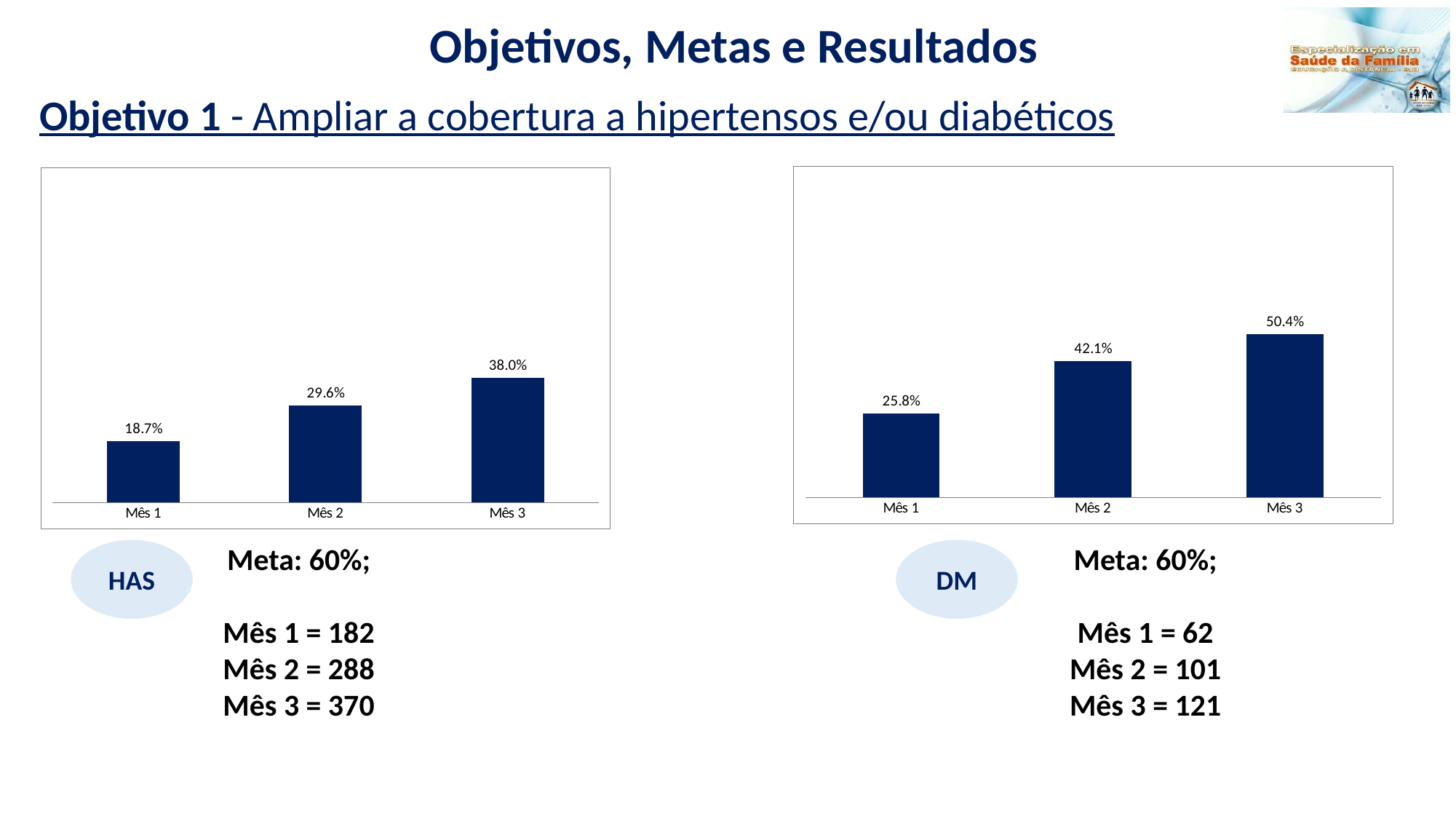
In the left chart (HAS), what is the value for Mês 3? 38.0% In the left chart (HAS), what is the difference between Mês 3 and Mês 1? 19.3% In the right chart (DM), what is the value for Mês 3? 50.4% What kind of chart is the right chart (DM)? Bar chart In the left chart (HAS), which month has the highest value? Mês 3 In the right chart (DM), which month has the lowest value? Mês 1 How many bars are in the left chart (HAS)? 3 Which is larger: Mês 2 in the left chart (HAS) or Mês 2 in the right chart (DM)? Mês 2 in the right chart (DM) In the left chart (HAS), what is the value for Mês 1? 18.7% In the right chart (DM), what is the value for Mês 2? 42.1% In the right chart (DM), what is the difference between Mês 2 and Mês 1? 16.3% In the right chart (DM), do the values rise or fall from Mês 1 to Mês 3? Rise